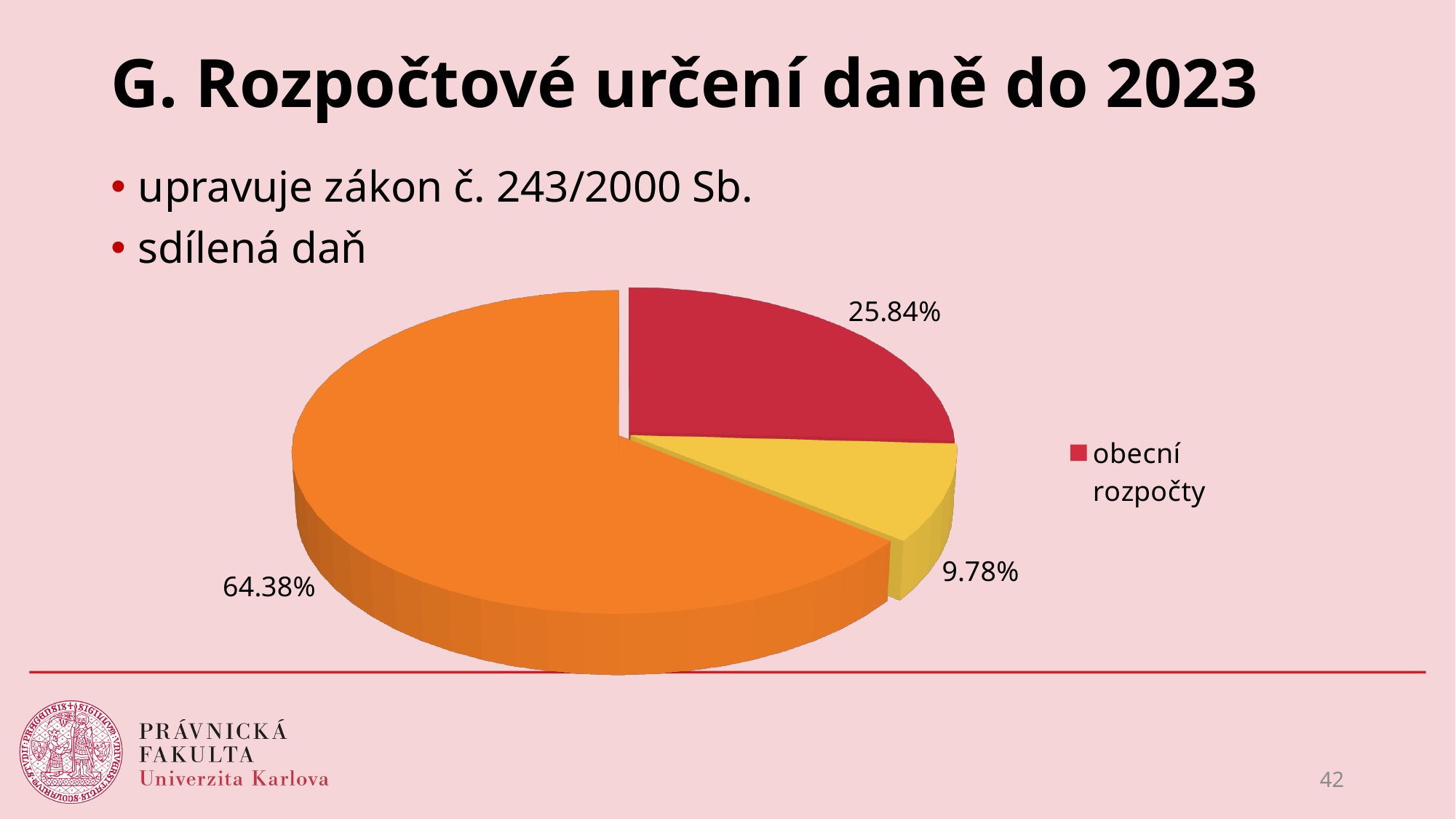
What is the value shown for the smallest slice of the pie chart? 9.78% By how many percentage points is the orange slice larger than the "obecní rozpočty" slice? 38.54 What colour is the slice labelled "obecní rozpočty" in the legend? red What share of the pie does the slice labelled "obecní rozpočty" represent? 25.84% What is the value of the yellow slice of the pie chart? 9.78% How many slices does the pie chart have? 3 Which is larger: the "obecní rozpočty" slice or the yellow slice? obecní rozpočty What kind of chart is shown on the slide? pie chart By how many percentage points is the "obecní rozpočty" slice larger than the yellow slice? 16.06 What is the value shown for the largest slice of the pie chart? 64.38% What is the value of the orange slice of the pie chart? 64.38% How many entries are shown in the chart's legend? 1